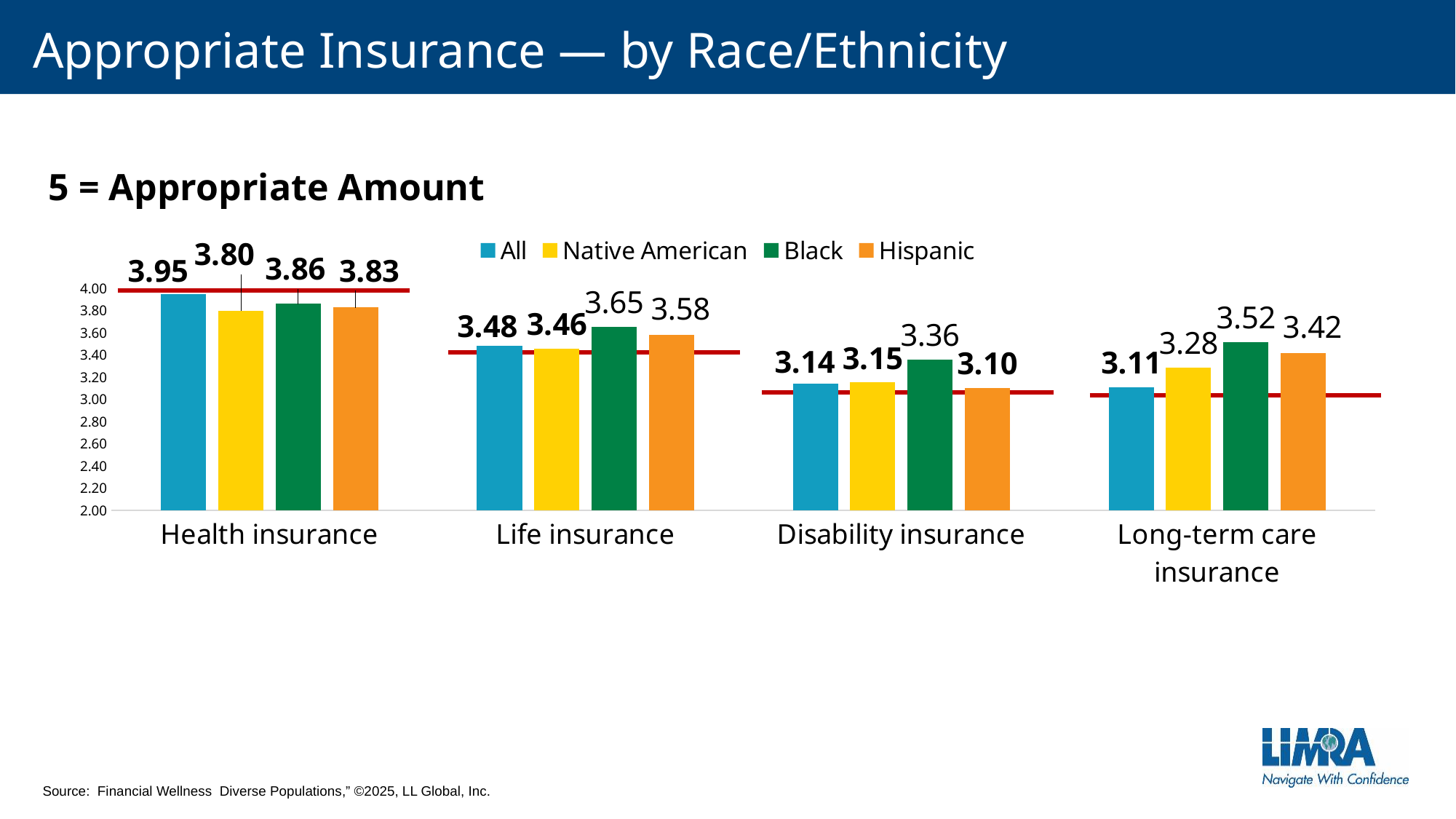
What kind of chart is shown on the slide? Bar chart What is the difference between the Black and Native American values for Life insurance? 0.19 How many insurance categories are shown on the x axis? 4 What is the value for Black respondents for Life insurance? 3.65 Which group has the highest value for Long-term care insurance? Black What is the value for Native American respondents for Disability insurance? 3.15 Which colour represents the Hispanic series in the legend? Orange How many series does the legend list? 4 What is the value for Hispanic respondents for Long-term care insurance? 3.42 Which is larger for Health insurance: the value for Black or the value for Hispanic? Black Which group has the lowest value for Disability insurance? Hispanic What is the value for All respondents for Health insurance? 3.95